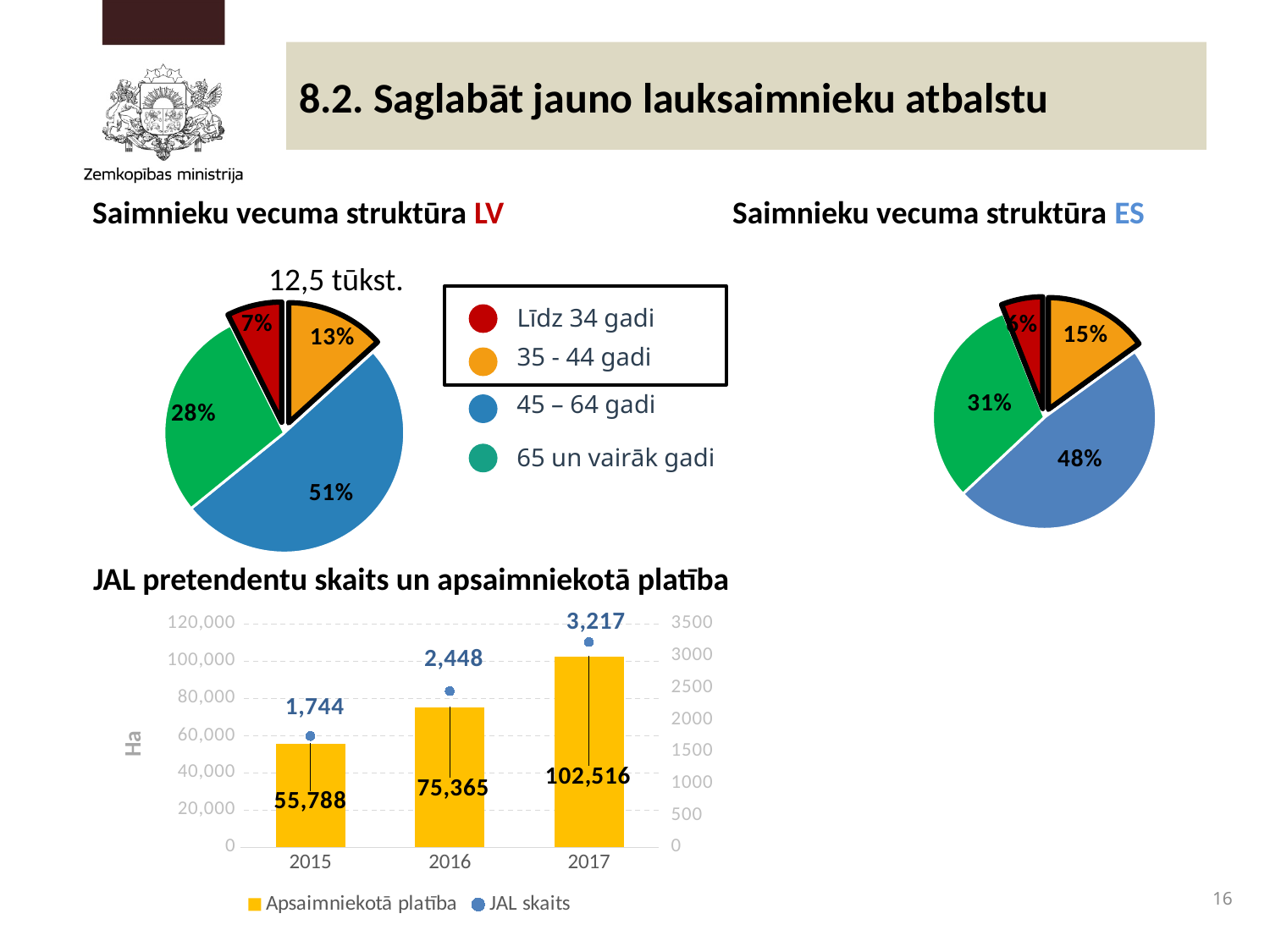
In the 'Saimnieku vecuma struktūra ES' pie chart, which age group has the largest slice? 45 – 64 gadi How many series does the legend of the 'JAL pretendentu skaits un apsaimniekotā platība' chart list? 2 In the 'JAL pretendentu skaits un apsaimniekotā platība' chart, what is the difference in 'Apsaimniekotā platība' between 2017 and 2015? 46,728 In the 'JAL pretendentu skaits un apsaimniekotā platība' chart, what is the 'Apsaimniekotā platība' value for 2016? 75,365 In the 'JAL pretendentu skaits un apsaimniekotā platība' chart, what is the 'JAL skaits' value for 2017? 3,217 In the 'Saimnieku vecuma struktūra LV' pie chart, which age group has the smallest slice? Līdz 34 gadi In the 'Saimnieku vecuma struktūra ES' pie chart, what share is the '65 un vairāk gadi' slice? 31% How many years are shown on the x axis of the 'JAL pretendentu skaits un apsaimniekotā platība' chart? 3 In the 'JAL pretendentu skaits un apsaimniekotā platība' chart, does 'JAL skaits' rise or fall from 2015 to 2017? rise In the 'Saimnieku vecuma struktūra LV' pie chart, what share is the '45 – 64 gadi' slice? 51% In the 'Saimnieku vecuma struktūra LV' pie chart, what share is the 'Līdz 34 gadi' slice? 7% Comparing the '35 - 44 gadi' slices, which pie chart shows the larger share, LV or ES? ES